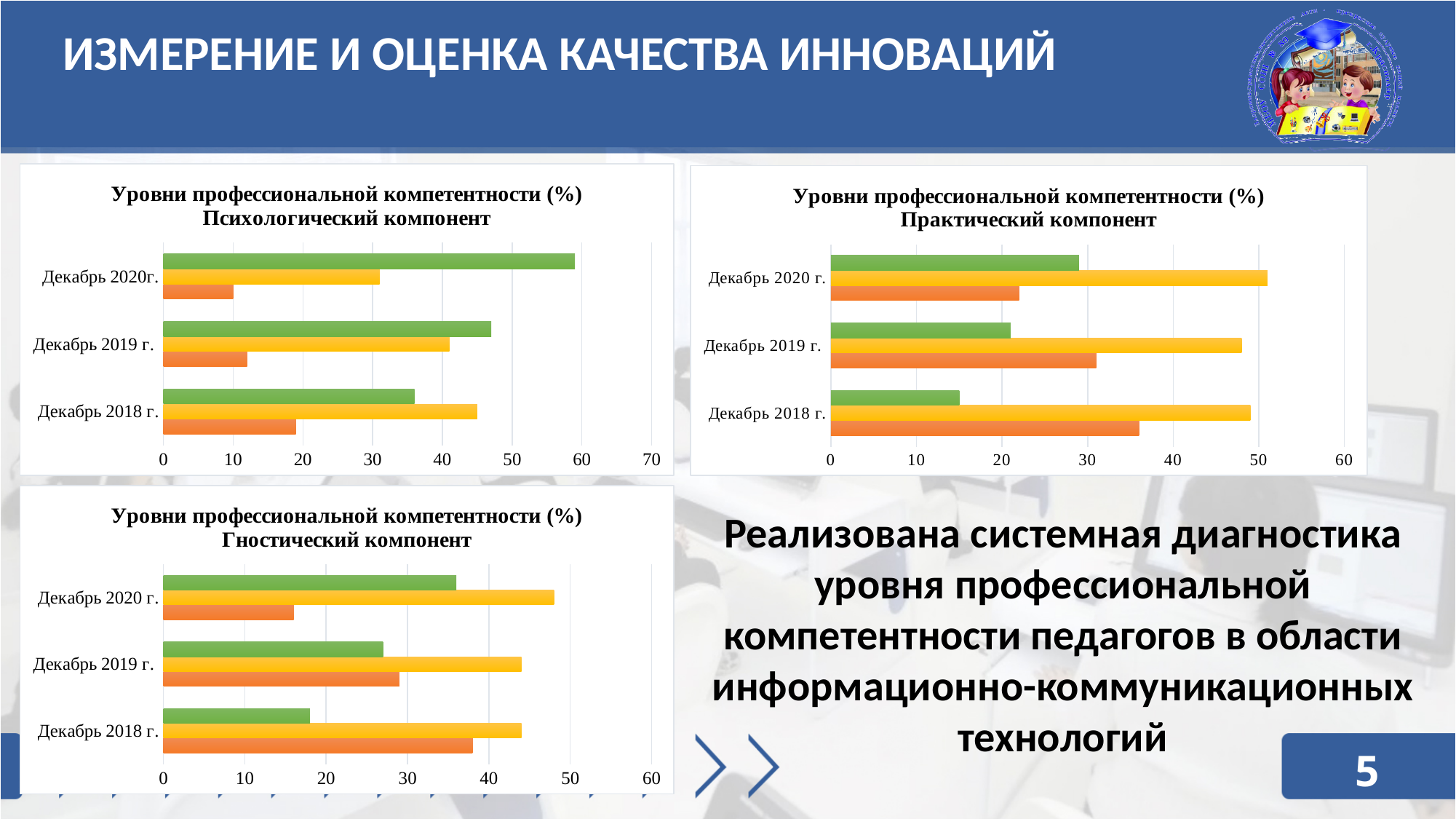
On the "Психологический компонент" chart, is the green bar for Декабрь 2020г. greater or less than 50? greater What kind of chart is the "Психологический компонент" chart? bar chart On the "Практический компонент" chart, is the green bar for Декабрь 2018 г. greater or less than 20? less On the "Практический компонент" chart, which date has the shortest green bar? Декабрь 2018 г. On the "Психологический компонент" chart, do the green bars increase or decrease from Декабрь 2018 г. to Декабрь 2020г.? increase How many categories (dates) are shown on the "Практический компонент" chart? 3 On the "Гностический компонент" chart, is the orange bar for Декабрь 2018 г. greater or less than 30? greater On the "Психологический компонент" chart, which date has the longest green bar? Декабрь 2020г. On the "Гностический компонент" chart, which is larger for Декабрь 2020 г.: the green bar or the orange bar? the green bar